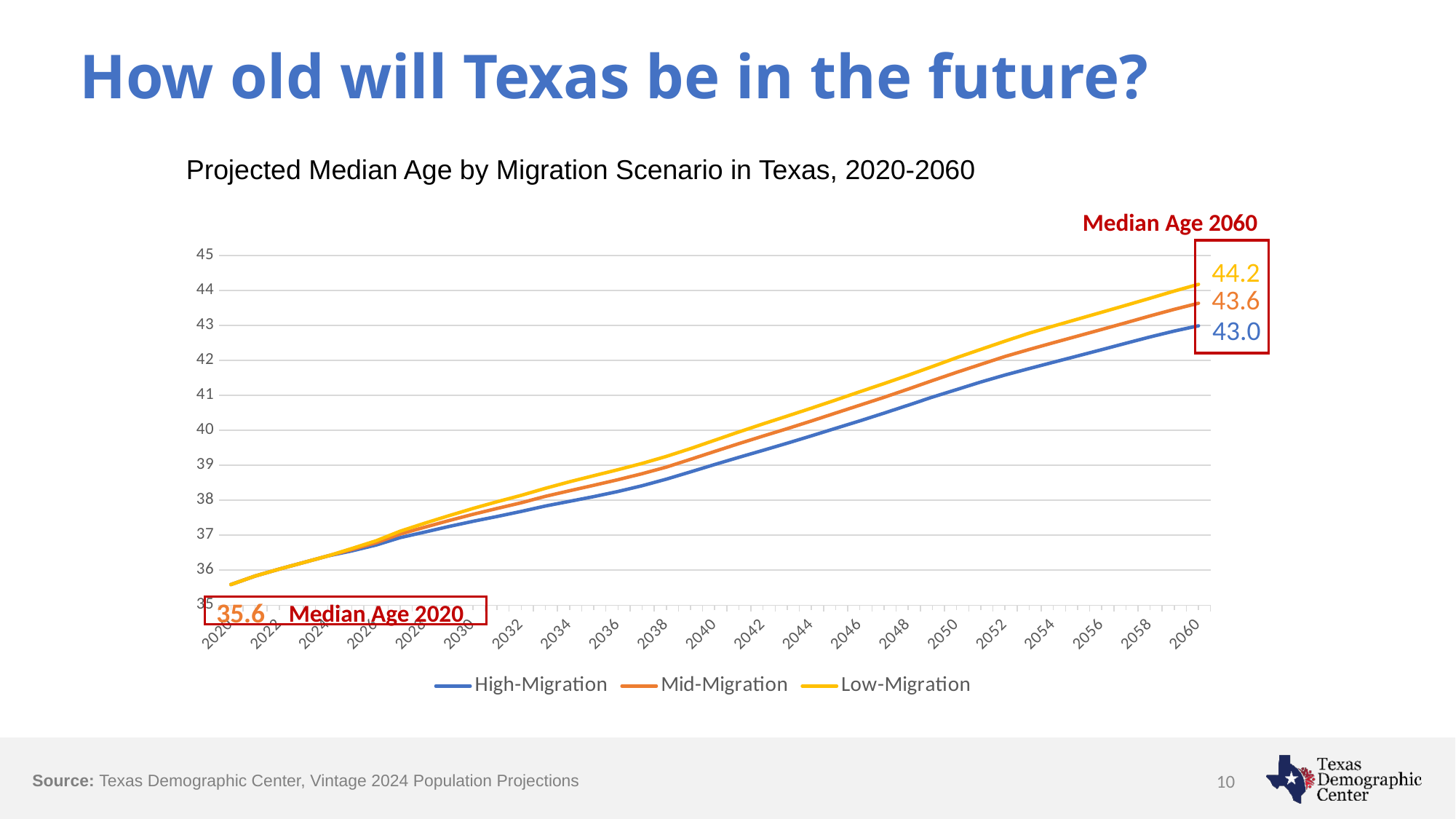
Which migration scenario has the highest projected median age in 2060? Low-Migration What kind of chart is shown on the slide? line chart Is the High-Migration median age in 2040 greater or less than 40? less What is the difference between the Low-Migration and High-Migration median ages in 2060? 1.2 Is the Mid-Migration median age in 2060 larger or smaller than the High-Migration median age in 2060? larger What is the projected median age in 2060 under the High-Migration scenario? 43.0 Do the projected median age values rise or fall from 2020 to 2060? rise Which migration scenario has the lowest projected median age in 2060? High-Migration How many series does the legend list? 3 What is the projected median age in 2060 under the Mid-Migration scenario? 43.6 What is the projected median age in 2060 under the Low-Migration scenario? 44.2 What is the median age shown for 2020? 35.6